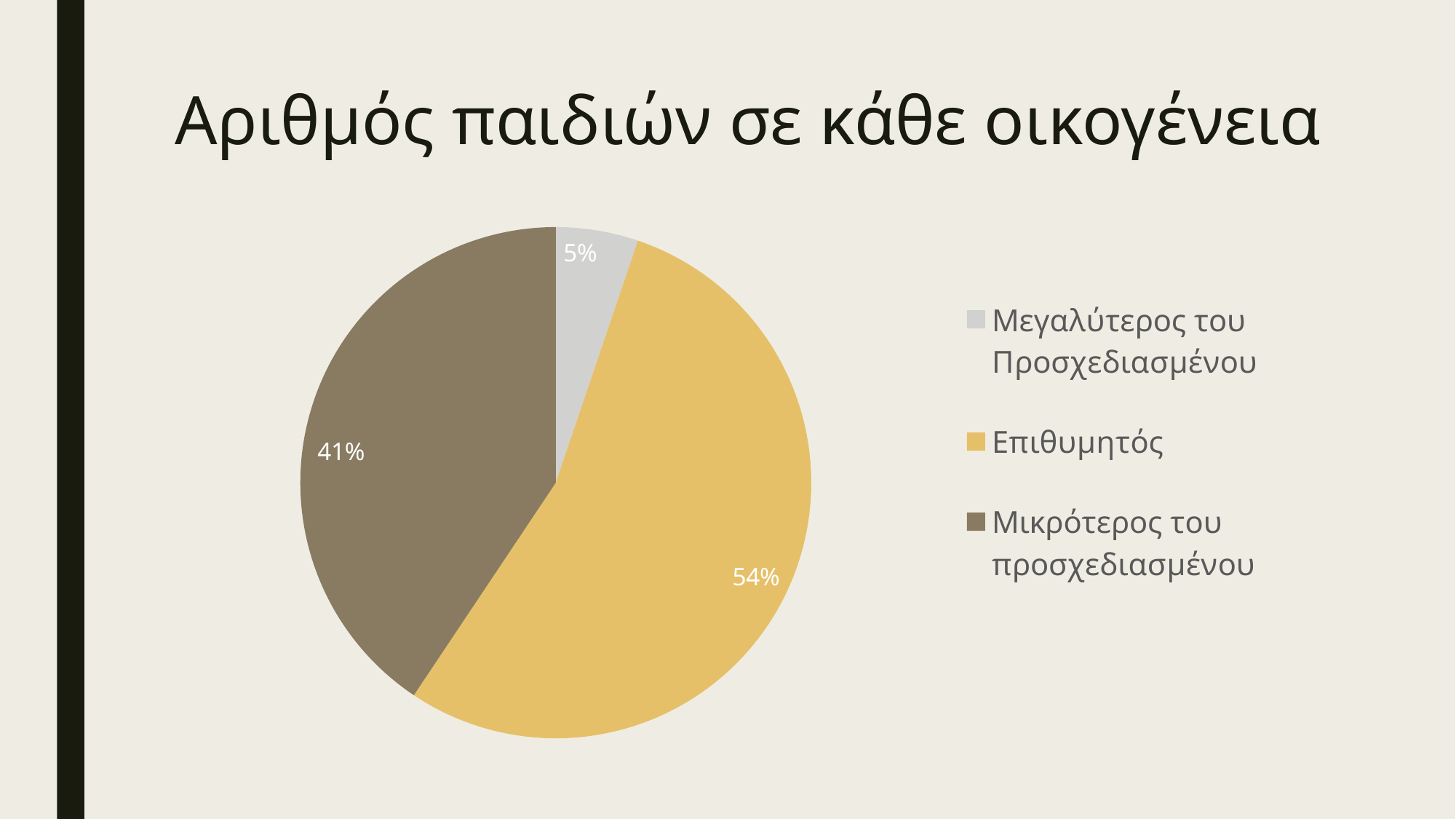
Which category has the smallest slice of the pie? Μεγαλύτερος του Προσχεδιασμένου What percentage of the pie is labelled Μεγαλύτερος του Προσχεδιασμένου? 5% What percentage of the pie is labelled Μικρότερος του προσχεδιασμένου? 41% What is the difference in percentage points between Μικρότερος του προσχεδιασμένου and Μεγαλύτερος του Προσχεδιασμένου? 36 What is the difference in percentage points between Επιθυμητός and Μικρότερος του προσχεδιασμένου? 13 Which category has the largest slice of the pie? Επιθυμητός What colour is the slice for Επιθυμητός? Yellow Which is larger, the slice for Επιθυμητός or the slice for Μικρότερος του προσχεδιασμένου? Επιθυμητός What is the title of the chart? Αριθμός παιδιών σε κάθε οικογένεια How many categories does the pie chart show? 3 What percentage of the pie is labelled Επιθυμητός? 54% What kind of chart is shown on the slide? Pie chart